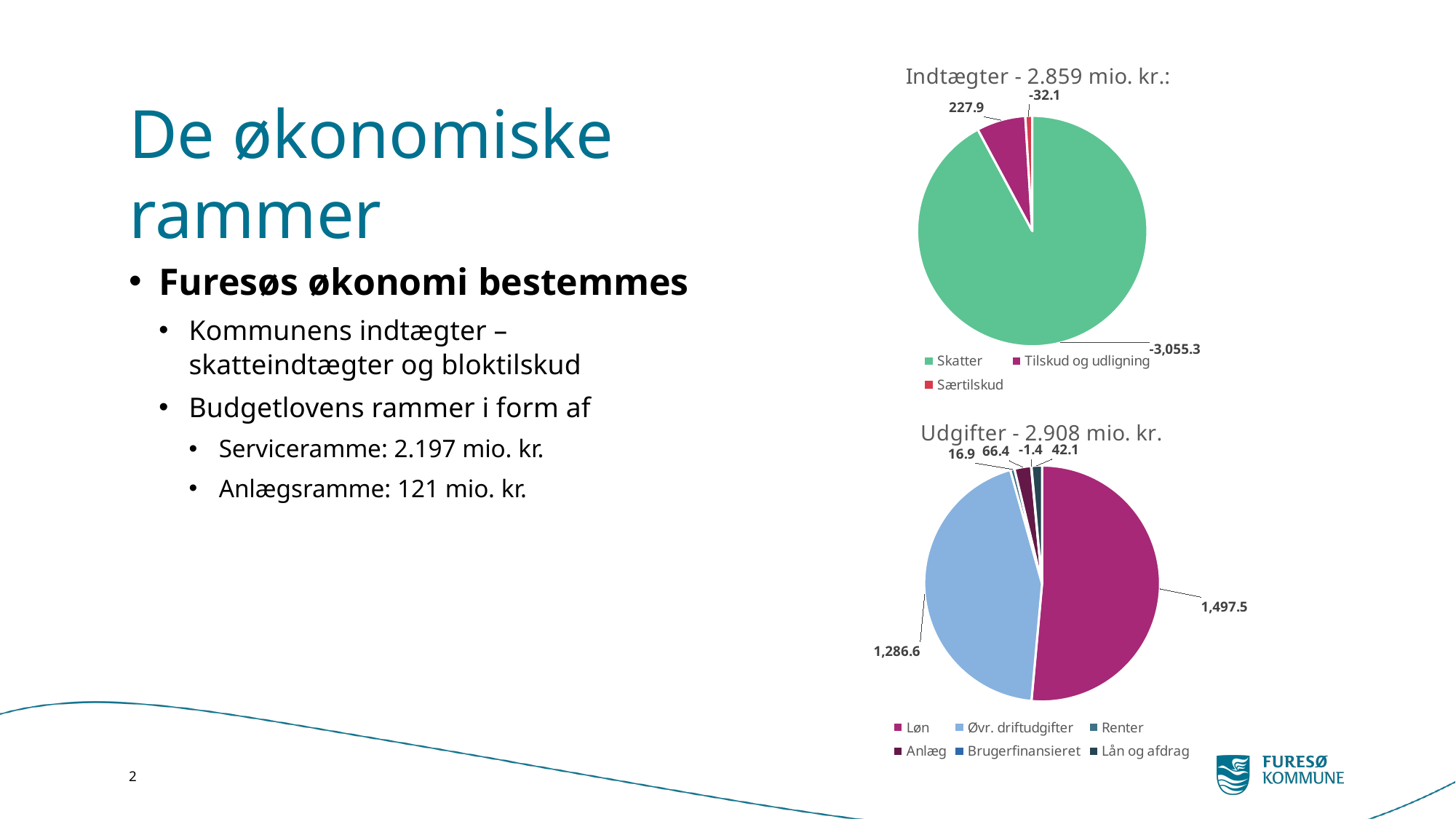
In the 'Indtægter - 2.859 mio. kr.' chart, what is the value for Særtilskud? -32.1 How many entries does the legend of the 'Udgifter - 2.908 mio. kr.' chart list? 6 In the 'Udgifter - 2.908 mio. kr.' chart, which is larger, Løn or Øvr. driftudgifter? Løn In the 'Udgifter - 2.908 mio. kr.' chart, what is the value for Øvr. driftudgifter? 1,286.6 In the 'Indtægter - 2.859 mio. kr.' chart, what is the value for Tilskud og udligning? 227.9 What is the title of the lower chart on the slide? Udgifter - 2.908 mio. kr. In the 'Indtægter - 2.859 mio. kr.' chart, which category has the largest slice? Skatter What kind of chart is the 'Indtægter - 2.859 mio. kr.' chart? pie chart In the 'Udgifter - 2.908 mio. kr.' chart, what is the value for Løn? 1,497.5 In the 'Udgifter - 2.908 mio. kr.' chart, what is the difference between the values for Løn and Øvr. driftudgifter? 210.9 In the 'Indtægter - 2.859 mio. kr.' chart, what is the value for Skatter? -3,055.3 How many entries does the legend of the 'Indtægter - 2.859 mio. kr.' chart list? 3